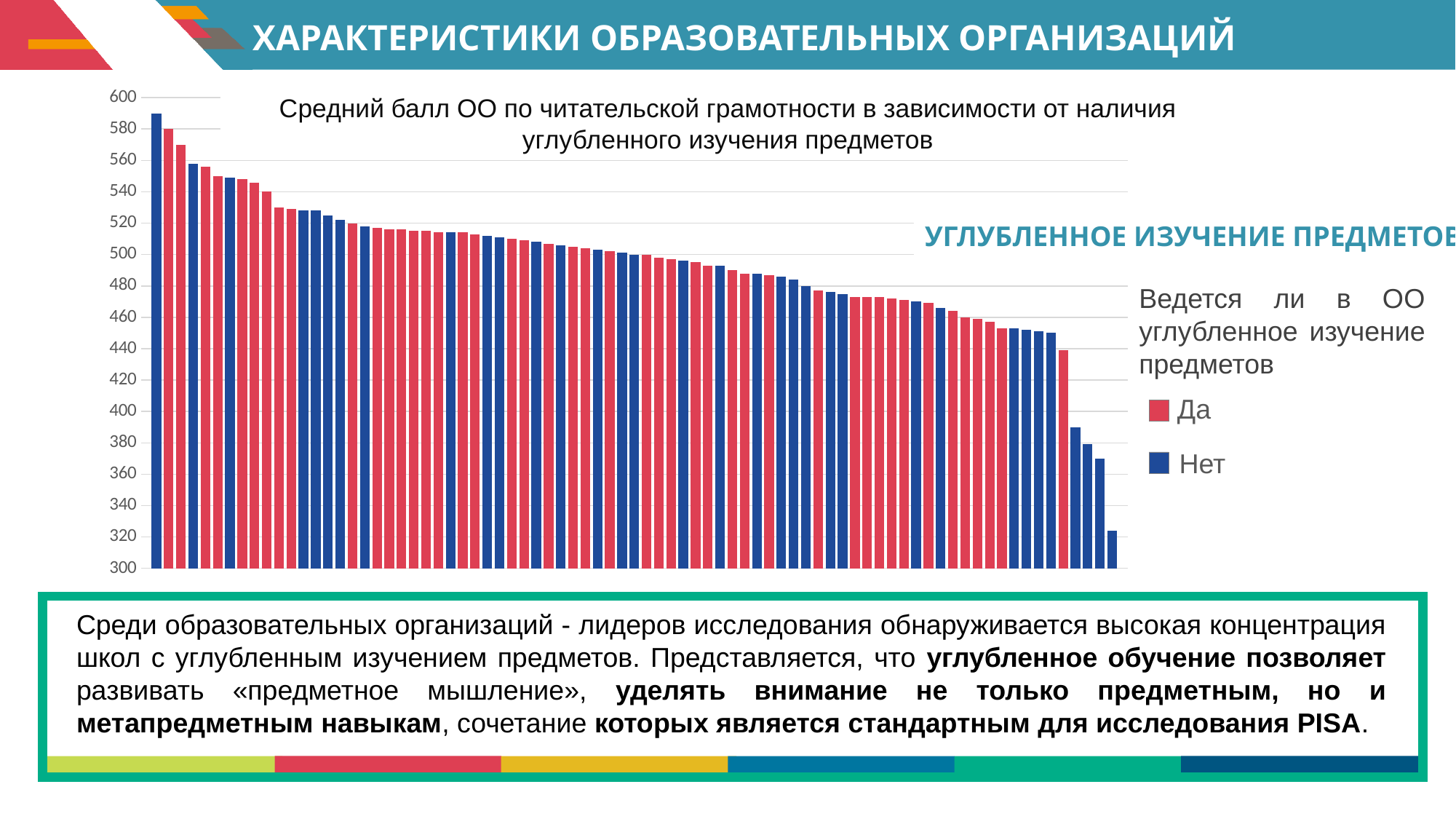
How many entries does the chart legend list? 2 What are the two legend entries of the chart? Да, Нет Which is larger, the leftmost bar or the rightmost bar? the leftmost bar Which legend category does the tallest bar belong to? Нет Which legend category does the shortest bar belong to? Нет What is the title of the chart? Средний балл ОО по читательской грамотности в зависимости от наличия углубленного изучения предметов Is the value of the shortest (rightmost) bar greater or less than 340? less Is the value of the second bar from the left greater or less than 560? greater What is the lowest value shown on the vertical axis? 300 What kind of chart is shown on the slide? bar chart Do the bar values rise or fall from left to right along the x axis? fall Is the value of the tallest (leftmost) bar greater or less than 580? greater